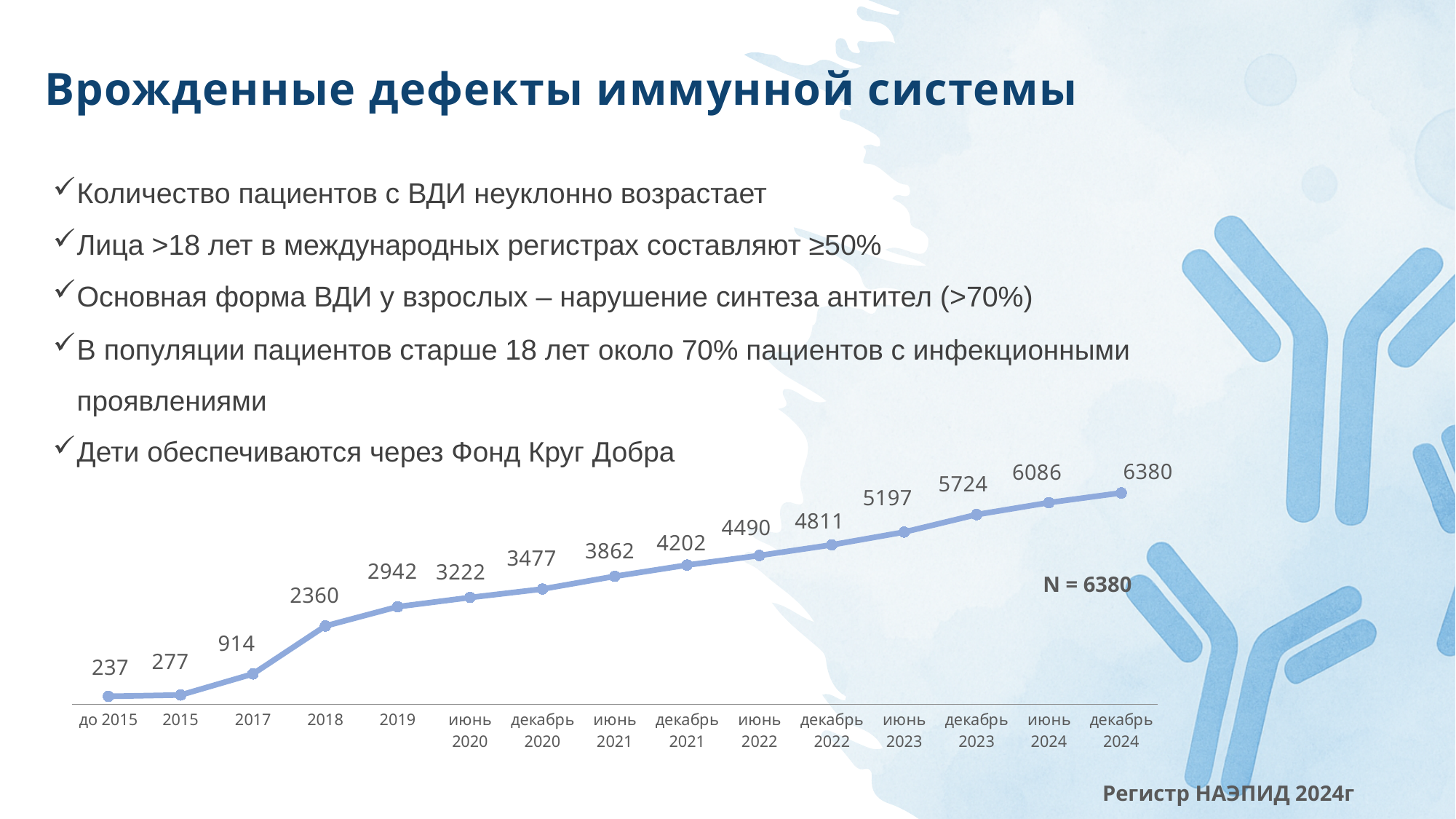
What is the difference between the values for 2018 and 2017? 1446 Which is larger, the value for декабрь 2021 or the value for июнь 2021? декабрь 2021 How many data points are plotted on the line chart? 15 What is the value for декабрь 2024 on the line chart? 6380 What is the difference between the values for декабрь 2024 and июнь 2024? 294 What kind of chart is shown on the slide? line chart Do the values rise or fall along the x axis from до 2015 to декабрь 2024? rise What is the value for до 2015 on the line chart? 237 What is the value for июнь 2022 on the line chart? 4490 Which category has the lowest value on the line chart? до 2015 What is the value for 2018 on the line chart? 2360 Which category has the highest value on the line chart? декабрь 2024